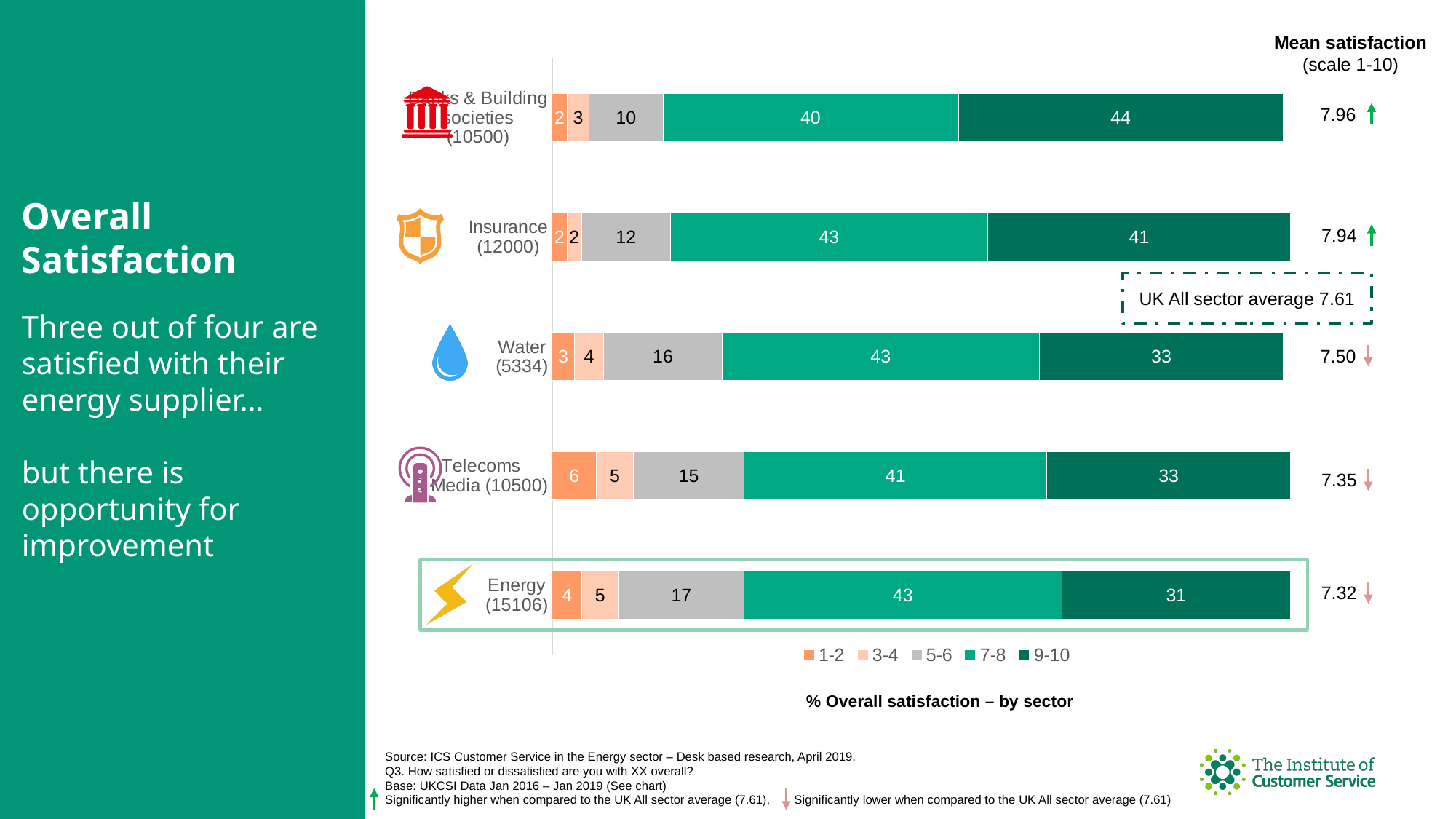
How many series does the legend list? 5 How many sectors are plotted in the chart? 5 Which sector has the highest mean satisfaction score? Banks & Building Societies What is the mean satisfaction score for Insurance? 7.94 What percentage of Water customers gave a score of 5-6? 16 What kind of chart is shown on the slide? Stacked bar chart Which is larger: the 7-8 percentage for Insurance or for Banks & Building Societies? Insurance Which sector has the lowest mean satisfaction score? Energy What is the difference between the 9-10 percentage for Banks & Building Societies and for Energy? 13 What is the UK All sector average mean satisfaction shown on the chart? 7.61 Which sector has the largest share of customers scoring 1-2? Telecoms & Media What percentage of Energy customers gave a score of 9-10? 31